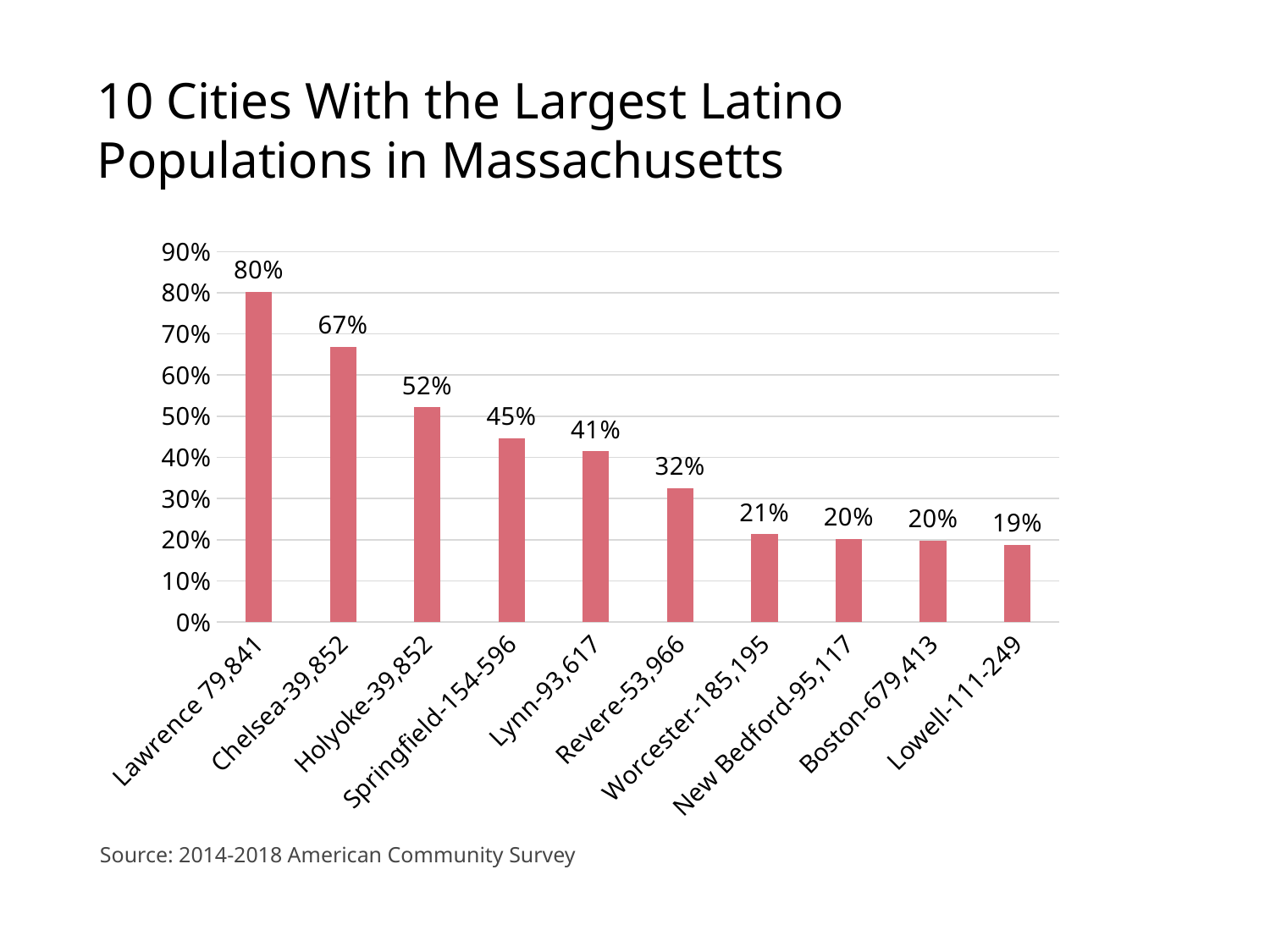
What kind of chart is shown on the slide? bar chart Which is larger, the value for Lynn-93,617 or the value for Revere-53,966? Lynn-93,617 What is the value for Springfield-154-596? 45% What is the value for Revere-53,966? 32% What is the value for Lawrence 79,841? 80% What is the difference between the values for Chelsea-39,852 and Holyoke-39,852? 15% What is the difference between the values for Lawrence 79,841 and Lowell-111-249? 61% Is the value for Holyoke-39,852 greater or less than 50%? greater Which city has the highest value? Lawrence 79,841 Do the values rise or fall from left to right along the x axis? fall How many cities are shown in the chart? 10 Which city has the lowest value? Lowell-111-249